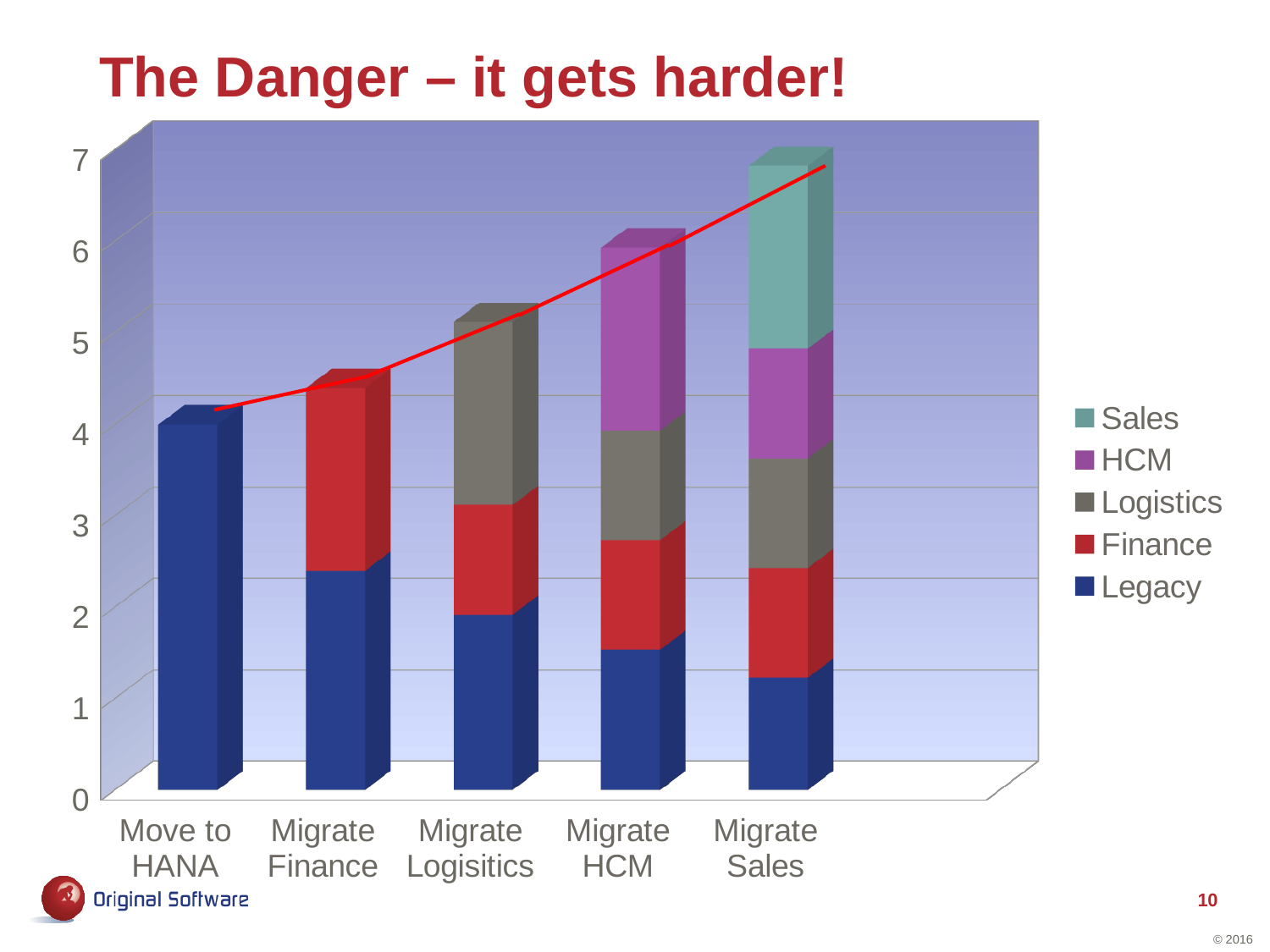
What is the title of the slide containing the chart? The Danger – it gets harder! Is the total for Migrate Sales greater or less than 6? greater Is the total for Move to HANA greater or less than 5? less Which category has the tallest stacked bar? Migrate Sales How many categories are shown along the x axis? 5 How many series does the legend list? 5 Which stacked bar is taller, Migrate HCM or Migrate Finance? Migrate HCM Which series is shown in dark blue at the bottom of each stacked bar? Legacy What kind of chart is shown on the slide? Stacked bar chart Do the stacked bar totals rise or fall from left to right along the x axis? Rise Is the total for Migrate HCM greater or less than 5? greater Which category has the shortest stacked bar? Move to HANA